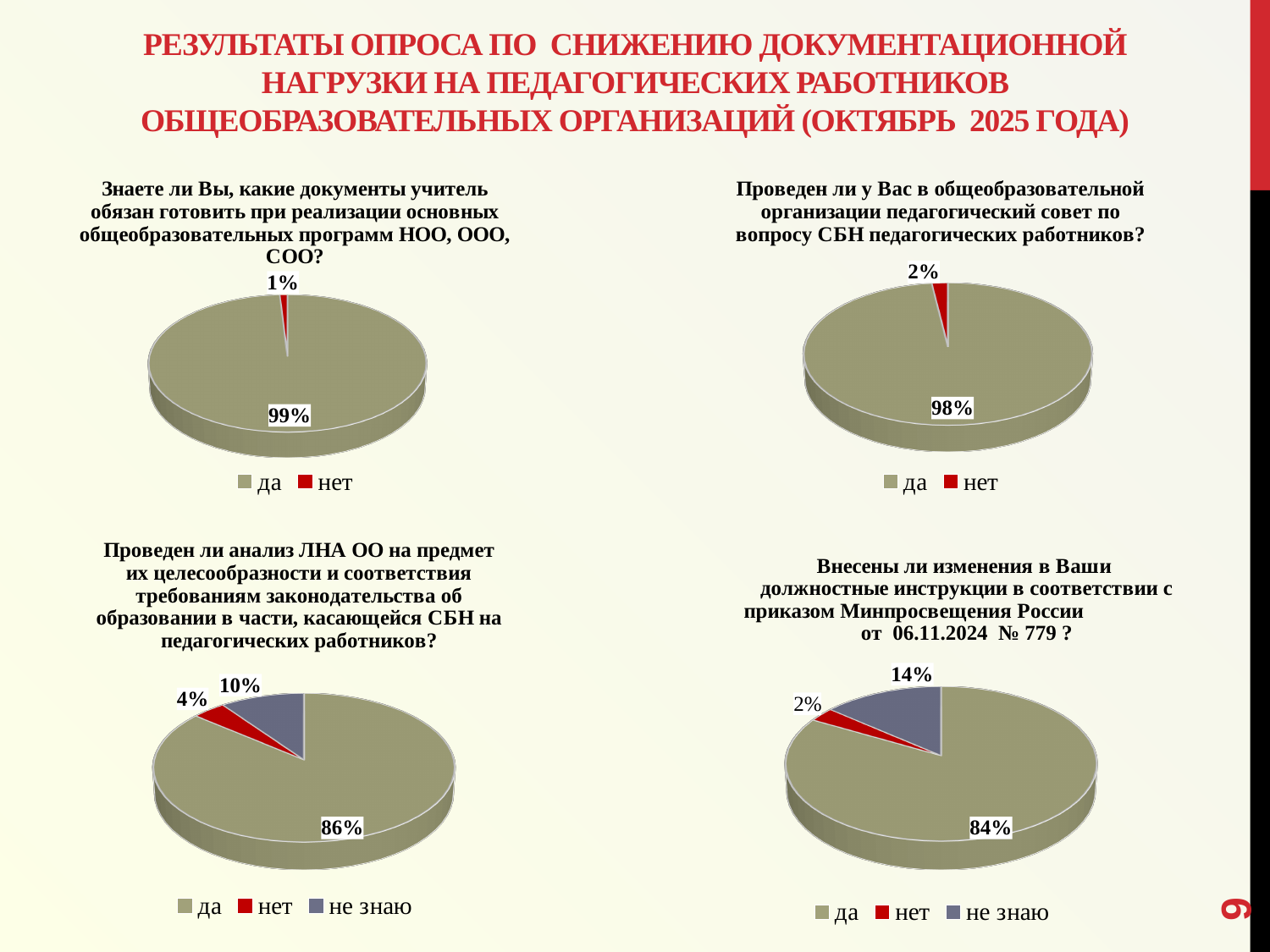
How many answer options does the legend of the bottom-left chart list? 3 In the bottom-left pie chart, what share of respondents answered "не знаю"? 10% In the top-left pie chart, what share of respondents answered "да"? 99% In the bottom-left pie chart, what share of respondents answered "нет"? 4% In the bottom-right pie chart, which is larger: the "не знаю" share or the "нет" share? не знаю In the top-right pie chart, what share of respondents answered "нет"? 2% In the bottom-right pie chart, what share of respondents answered "да"? 84% In the bottom-right pie chart, which answer has the smallest share? нет In the bottom-left pie chart, what is the difference between the "да" share and the "не знаю" share? 76% In the top-right pie chart, what share of respondents answered "да"? 98% In the top-left pie chart, what share of respondents answered "нет"? 1% What type of chart is used for the top-right chart? pie chart